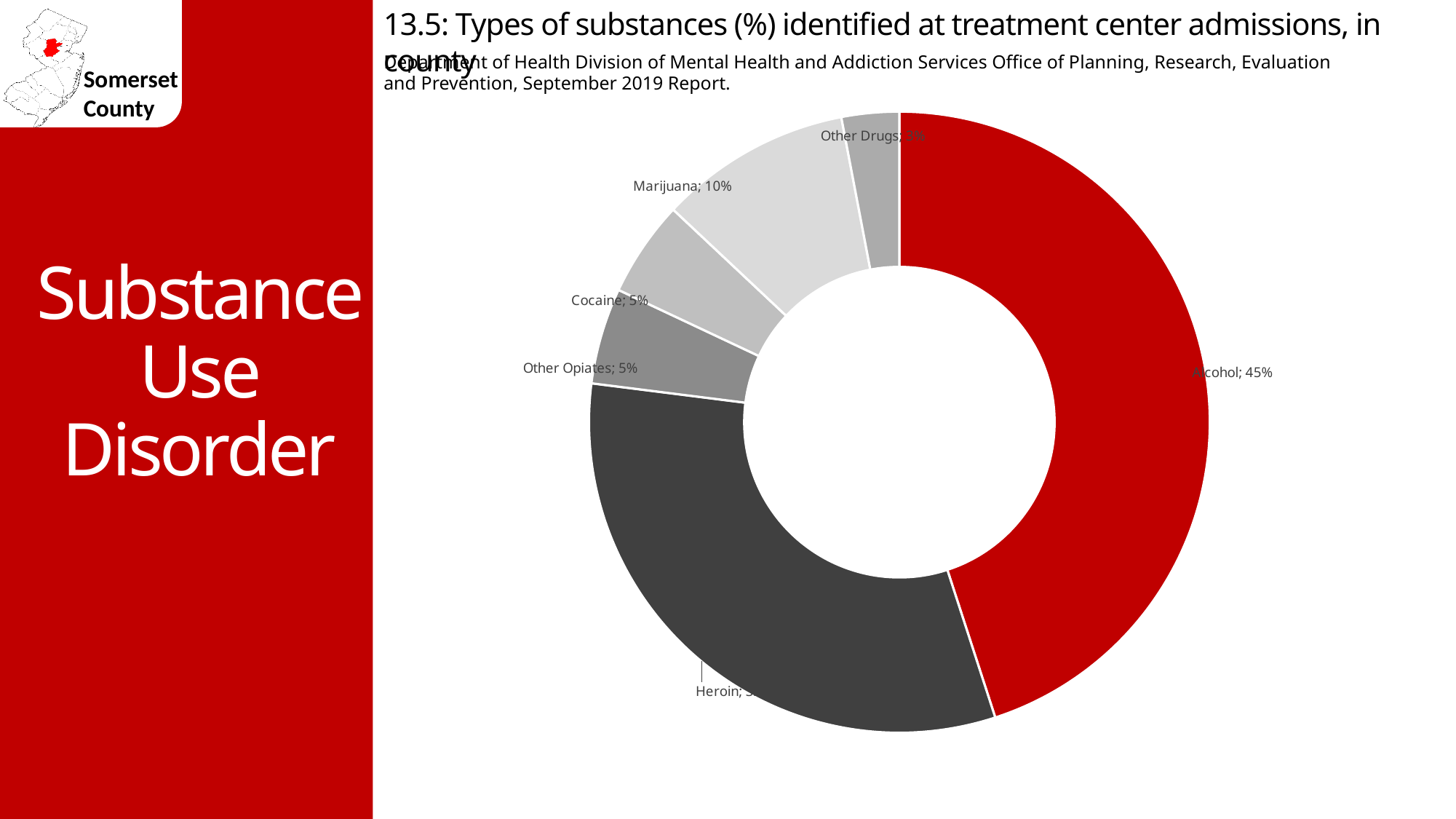
How many substance categories are shown in the chart? 6 How many percentage points higher is Alcohol than Marijuana? 35 percentage points Which substance has the smallest slice in the chart? Other Drugs Which is larger, the share for Alcohol or the share for Heroin? Alcohol What percentage is shown for Marijuana? 10% What percentage is shown for Cocaine? 5% Which substance has the largest share of admissions? Alcohol What kind of chart is shown on the slide? doughnut (pie) chart What colour is the Alcohol slice? red What percentage of treatment center admissions identified Alcohol? 45% Which is larger, the share for Marijuana or the share for Cocaine? Marijuana What percentage is shown for Other Opiates? 5%